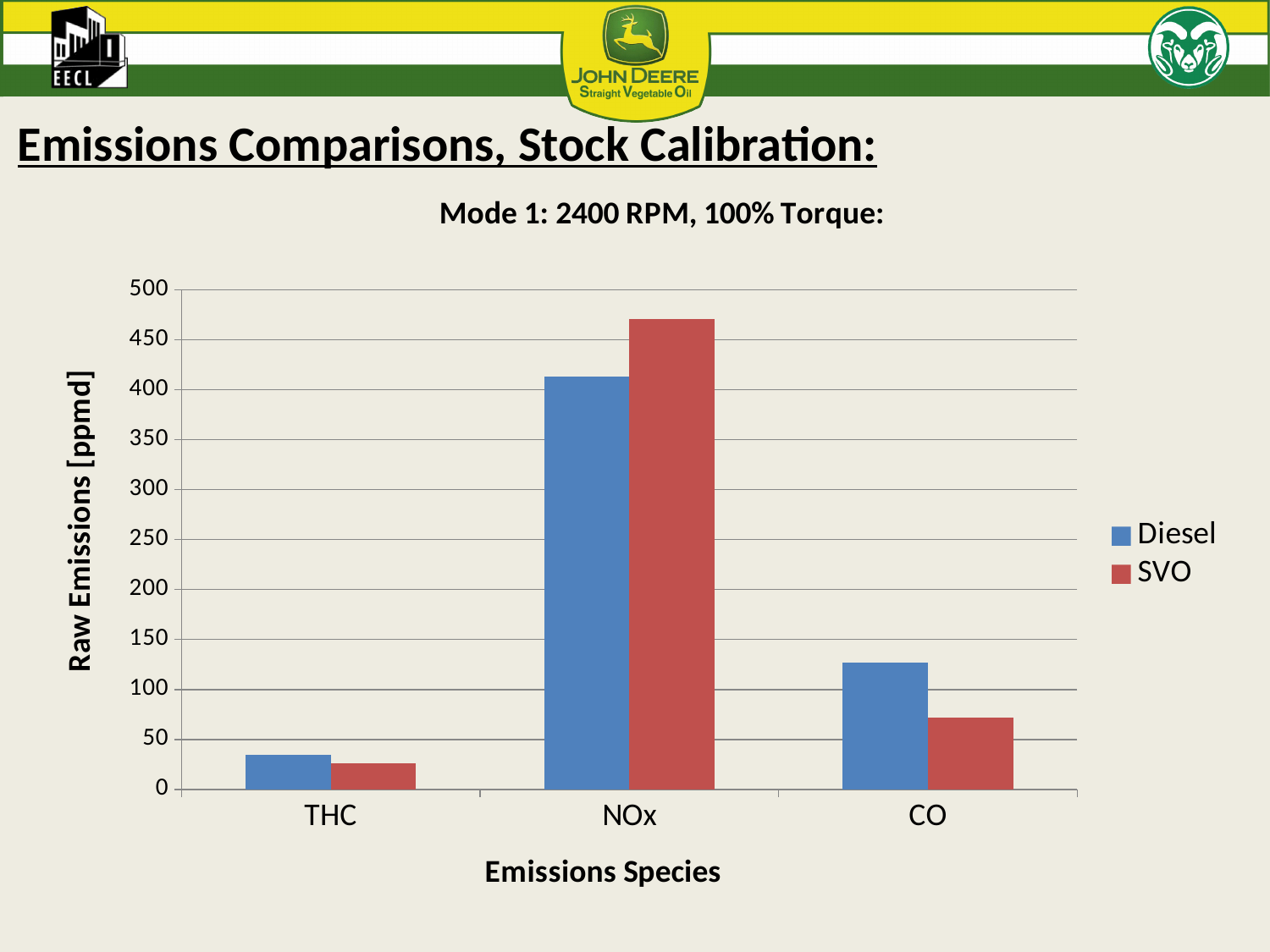
What is the title of the chart? Mode 1: 2400 RPM, 100% Torque: How many series does the legend list? 2 Which emissions species has the highest Diesel value? NOx Is the SVO value for CO greater or less than 100? less Is the SVO value for NOx greater or less than 450? greater What kind of chart is shown on the slide? bar chart Which emissions species has the lowest SVO value? THC Is the Diesel value for CO greater or less than 100? greater What is the label of the y axis? Raw Emissions [ppmd] For CO, which is larger, the Diesel value or the SVO value? Diesel For NOx, which is larger, the Diesel value or the SVO value? SVO How many emissions species categories are shown on the x axis? 3